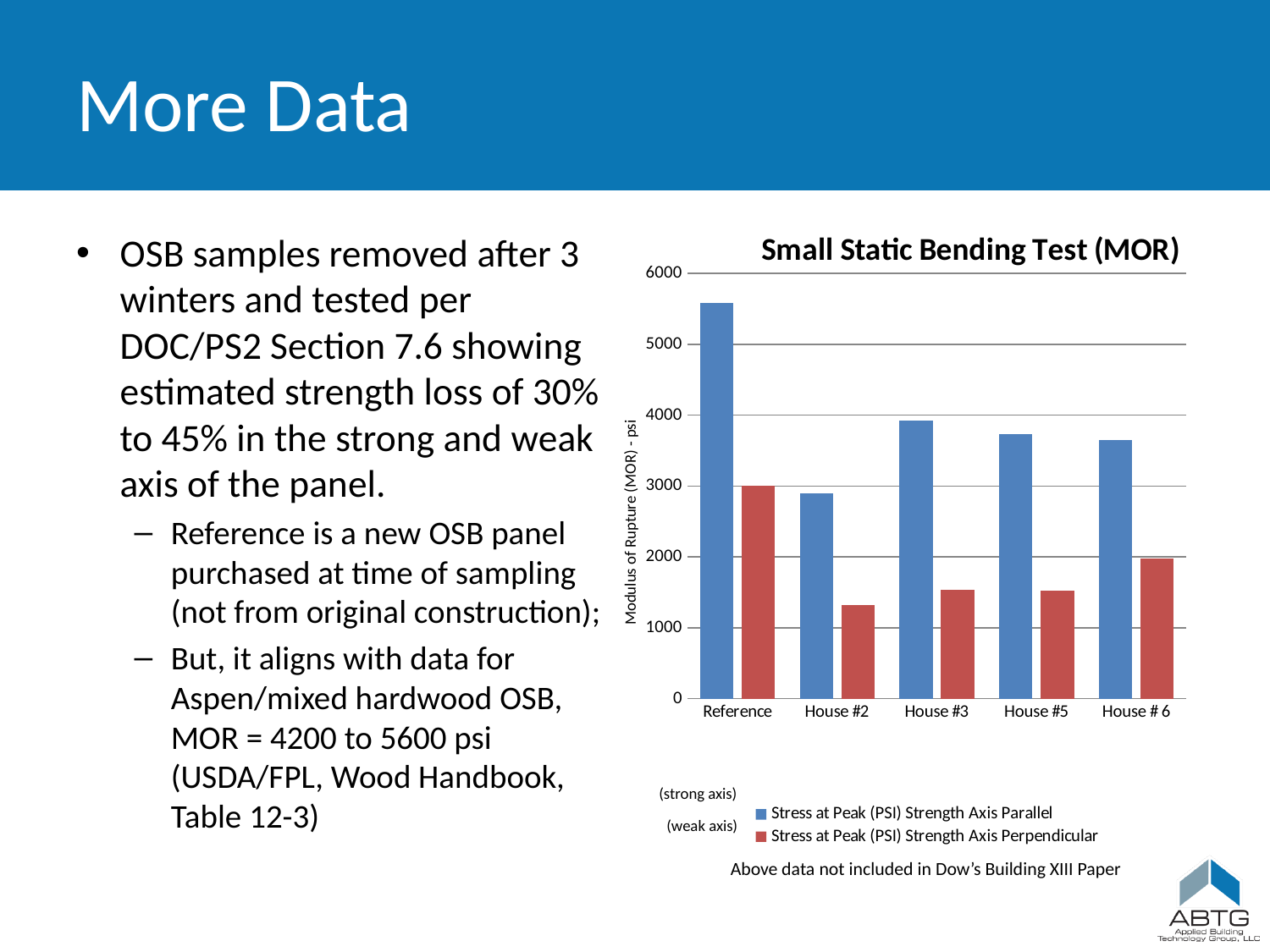
Which category has the highest Stress at Peak (PSI) Strength Axis Parallel value? Reference Is the Strength Axis Parallel value for House #5 greater or less than 3000? greater What is the title of the chart? Small Static Bending Test (MOR) What kind of chart is shown on the slide? bar chart How many categories are shown on the x axis of the chart? 5 Which is larger, the Strength Axis Perpendicular value for House # 6 or for House #2? House # 6 Is the Strength Axis Parallel value for Reference greater or less than 5000? greater Is the Strength Axis Perpendicular value for House #2 greater or less than 2000? less Which is larger, the Strength Axis Parallel value for Reference or for House #2? Reference Which category has the lowest Stress at Peak (PSI) Strength Axis Perpendicular value? House #2 How many series does the chart's legend list? 2